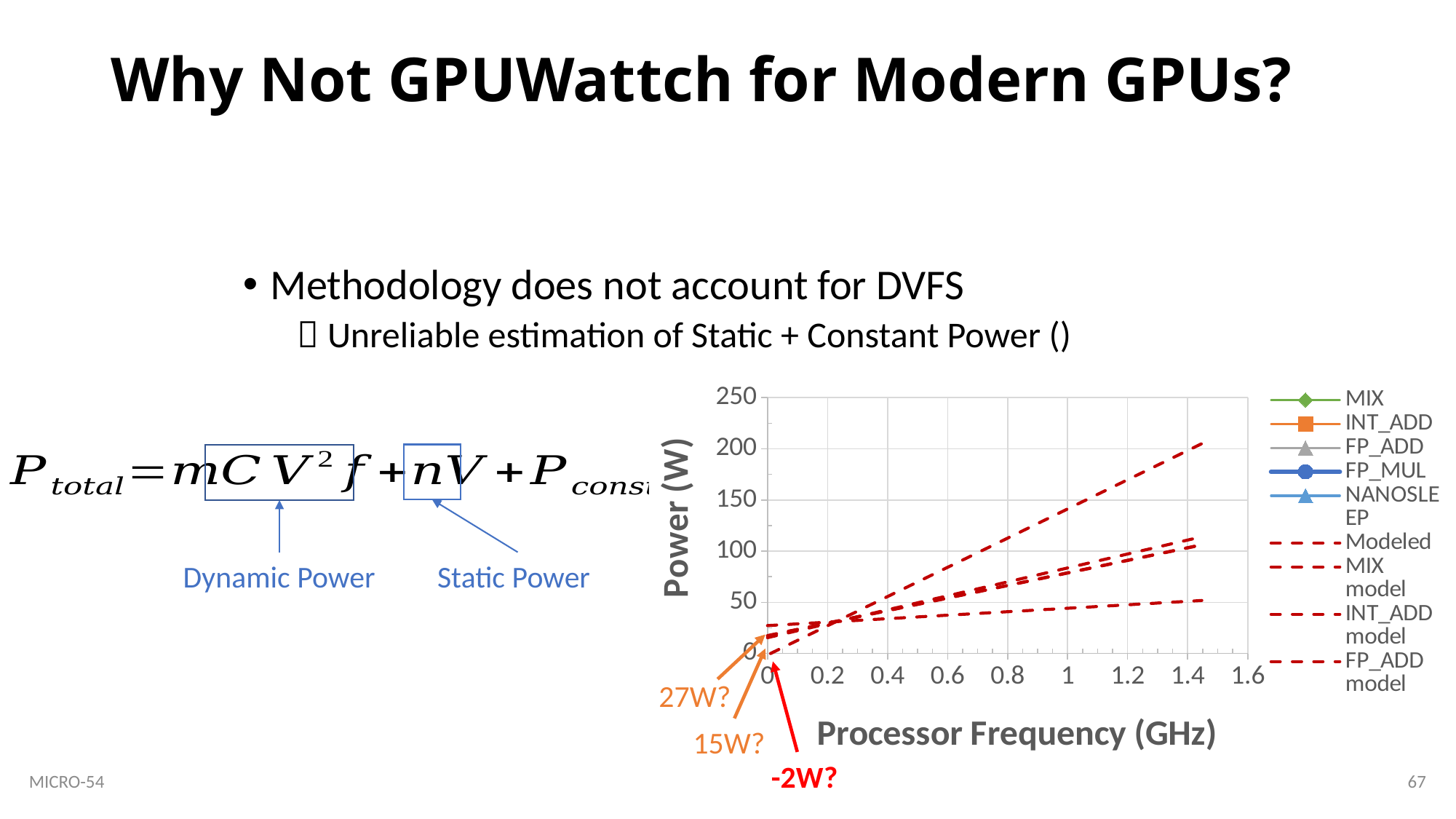
Is the value of the steepest dashed line at 1.4 GHz greater or less than 150? greater What is the title of the y axis of the chart? Power (W) Do the plotted lines rise or fall as processor frequency increases? rise How many entries does the chart's legend list? 9 Is the value of the steepest dashed line at 0.8 GHz greater or less than 50? greater Is the value of the shallowest dashed line at 1.4 GHz greater or less than 100? less What is the highest tick value shown on the x axis? 1.6 What is the highest tick value shown on the y axis? 250 What kind of chart is shown on the slide? line chart